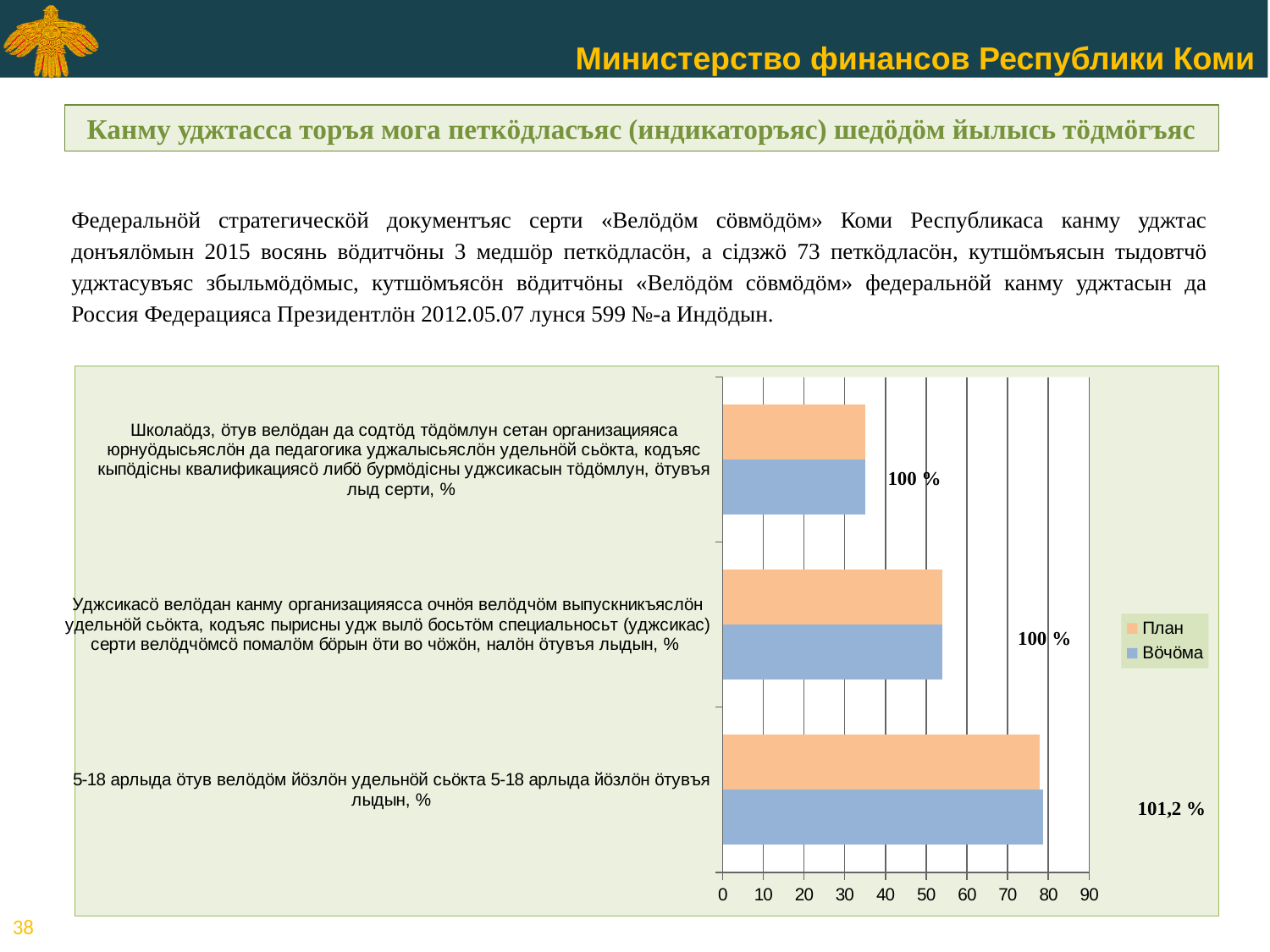
Is the Вöчöма value for the category starting "Школаöдз" greater or less than 40? less Is the План value for the category starting "Уджсикасö велöдан" greater or less than 50? greater How many categories are plotted on the chart? 3 What are the two series named in the chart legend? План, Вöчöма What is the highest tick value shown on the horizontal axis? 90 What kind of chart is shown on the slide? bar chart Which is larger: the Вöчöма value for the category starting "Уджсикасö велöдан" or the Вöчöма value for the category starting "Школаöдз"? Уджсикасö велöдан Which category has the shortest bars on the chart? Школаöдз, öтув велöдан да содтöд тöдöмлун сетан организацияяса юрнуöдысьяслöн да педагогика уджалысьяслöн удельнöй сьöкта, ... How many series does the chart legend list? 2 Which category has the longest bars on the chart? 5-18 арлыда öтув велöдöм йöзлöн удельнöй сьöкта 5-18 арлыда йöзлöн öтувъя лыдын, % What percentage label is printed next to the bars for the category starting "5-18 арлыда"? 101,2 % Is the План value for the category starting "5-18 арлыда" greater or less than 70? greater